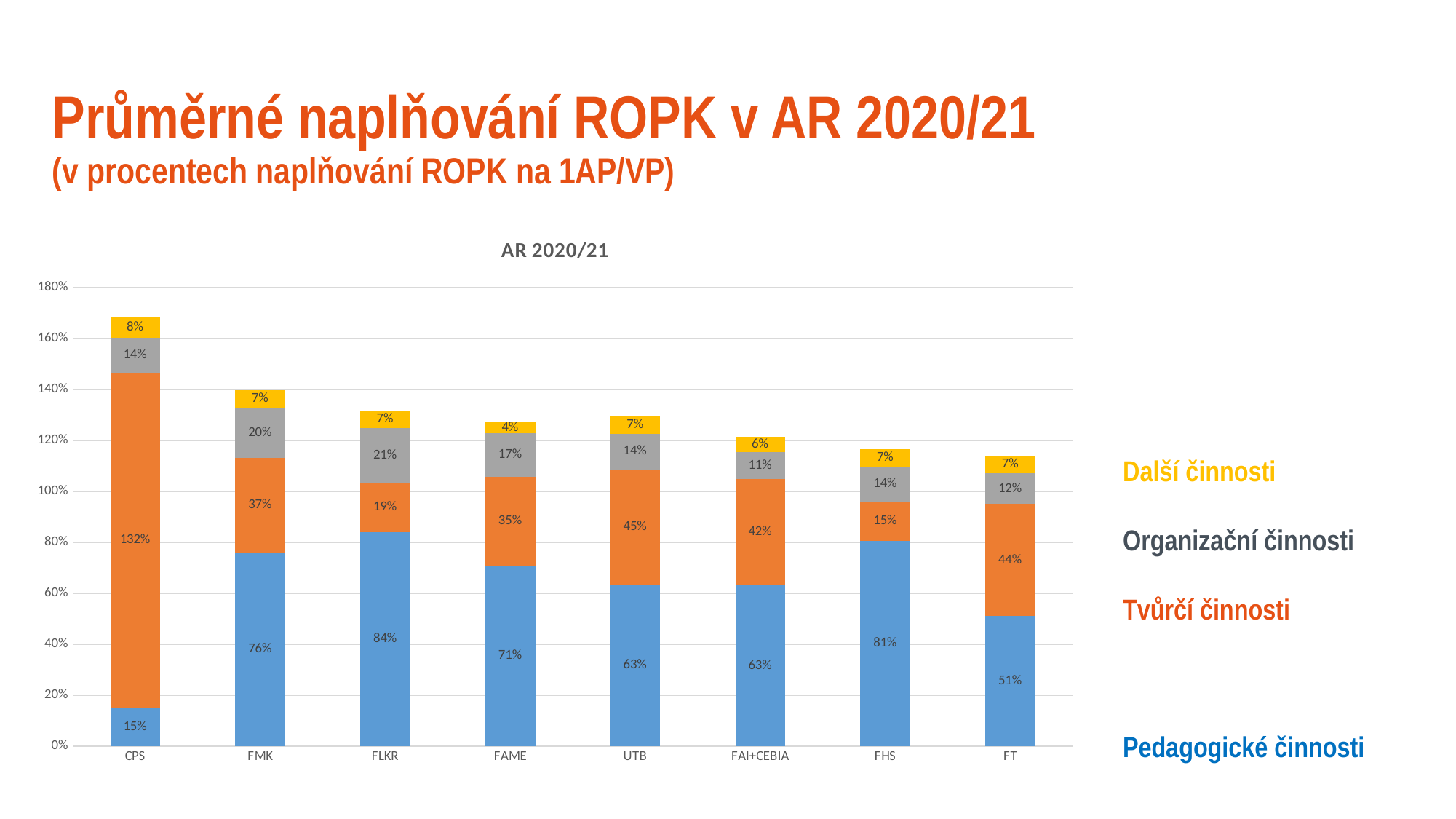
What is the value of Tvůrčí činnosti for CPS? 132% What is the value of Organizační činnosti for FMK? 20% What is the value of Pedagogické činnosti for FLKR? 84% What is the value of Další činnosti for FAME? 4% How many series does the chart show? 4 Which is larger, the Organizační činnosti value for FLKR or for FT? FLKR Which category has the highest value for Pedagogické činnosti? FLKR What kind of chart is shown on the slide? Stacked bar chart What is the difference between the Tvůrčí činnosti values for UTB and FHS? 30% What is the total of the stacked bar for FHS? 117% How many categories are shown on the x axis? 8 Which category has the lowest value for Pedagogické činnosti? CPS